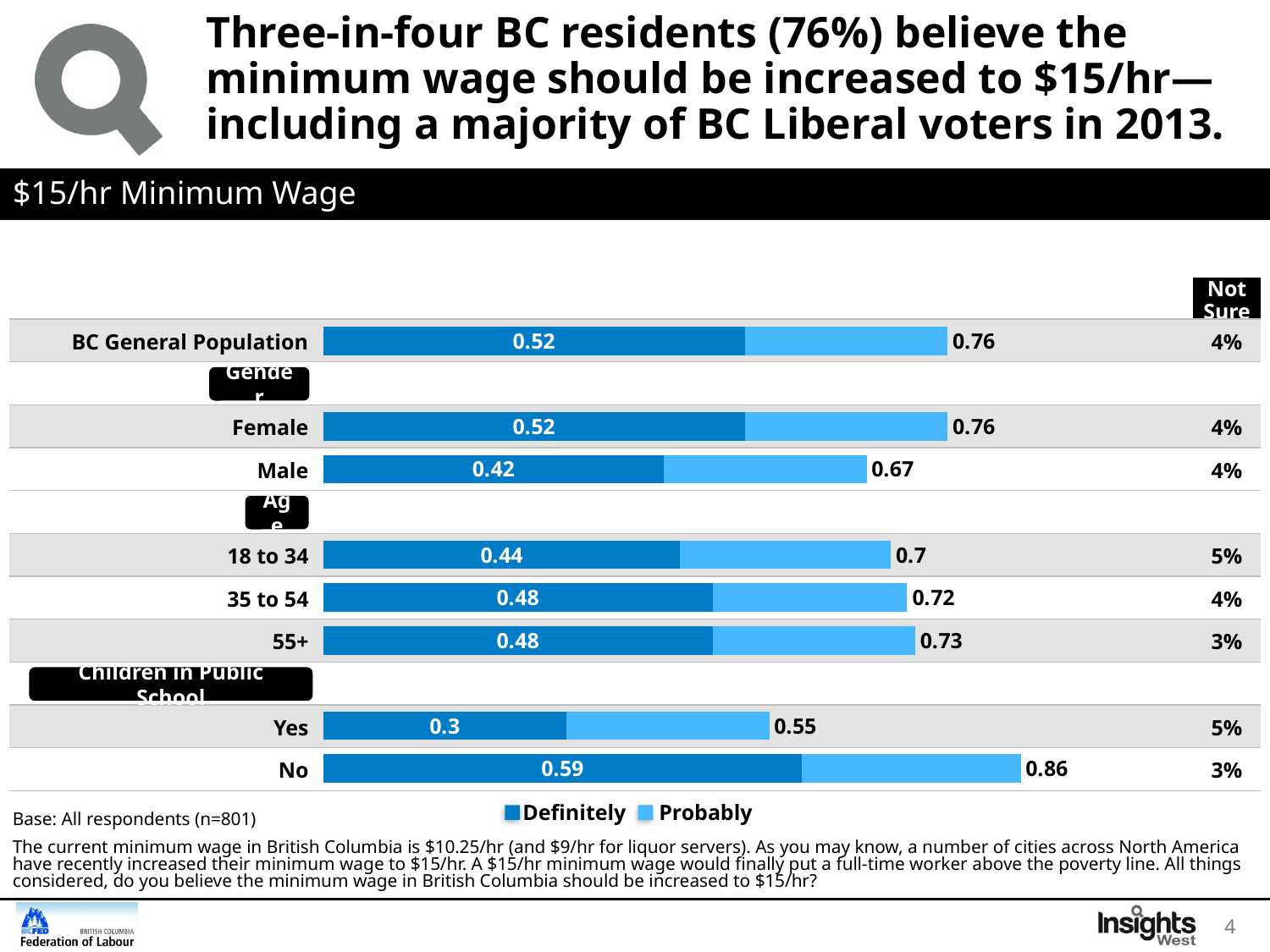
What is the difference between the 'Definitely' values for 'No' and 'Yes'? 0.29 What are the two series named in the legend? Definitely and Probably Which category has the lowest 'Definitely' value? Yes Which category has the highest total value at the end of its bar? No How many series does the legend list? 2 What type of chart is shown on the slide? Stacked bar chart What is the 'Not Sure' percentage for the 18 to 34 age group? 5% What is the total value shown at the end of the bar for the 55+ age group? 0.73 What is the 'Definitely' value for Male? 0.42 Which has a higher 'Definitely' value, Female or Male? Female What is the total value shown at the end of the bar for 'No' (Children in Public School)? 0.86 How many categories (bars) are plotted in the chart? 8